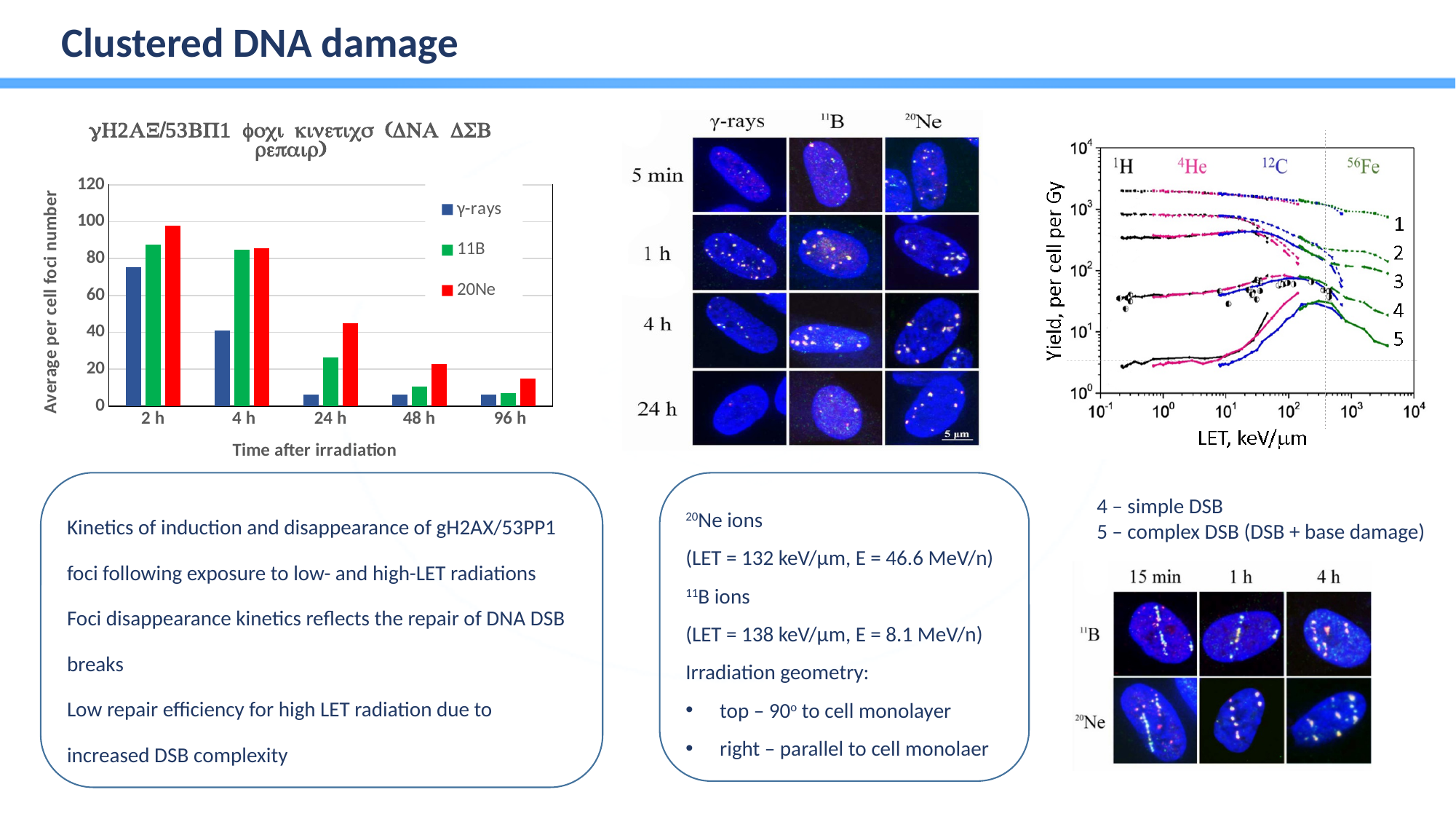
In the bar chart on the left, which series has the lowest value at 4 h? γ-rays In the bar chart on the left, at 24 h, which is larger: the 11B value or the 20Ne value? 20Ne In the bar chart on the left, at 2 h, which is larger: the γ-rays value or the 20Ne value? 20Ne What kind of chart is the chart on the left of the slide? bar chart In the bar chart on the left, how many series does the legend list? 3 In the bar chart on the left, is the γ-rays value at 4 h greater or less than 60? less In the bar chart on the left, at which time point is the 20Ne value highest? 2 h In the bar chart on the left, how many time points are shown on the x axis? 5 In the bar chart on the left, do the 20Ne values rise or fall as time after irradiation increases? fall In the bar chart on the left, is the 20Ne value at 24 h greater or less than 60? less What is the x-axis title of the bar chart on the left? Time after irradiation In the bar chart on the left, is the γ-rays value at 2 h greater or less than 60? greater